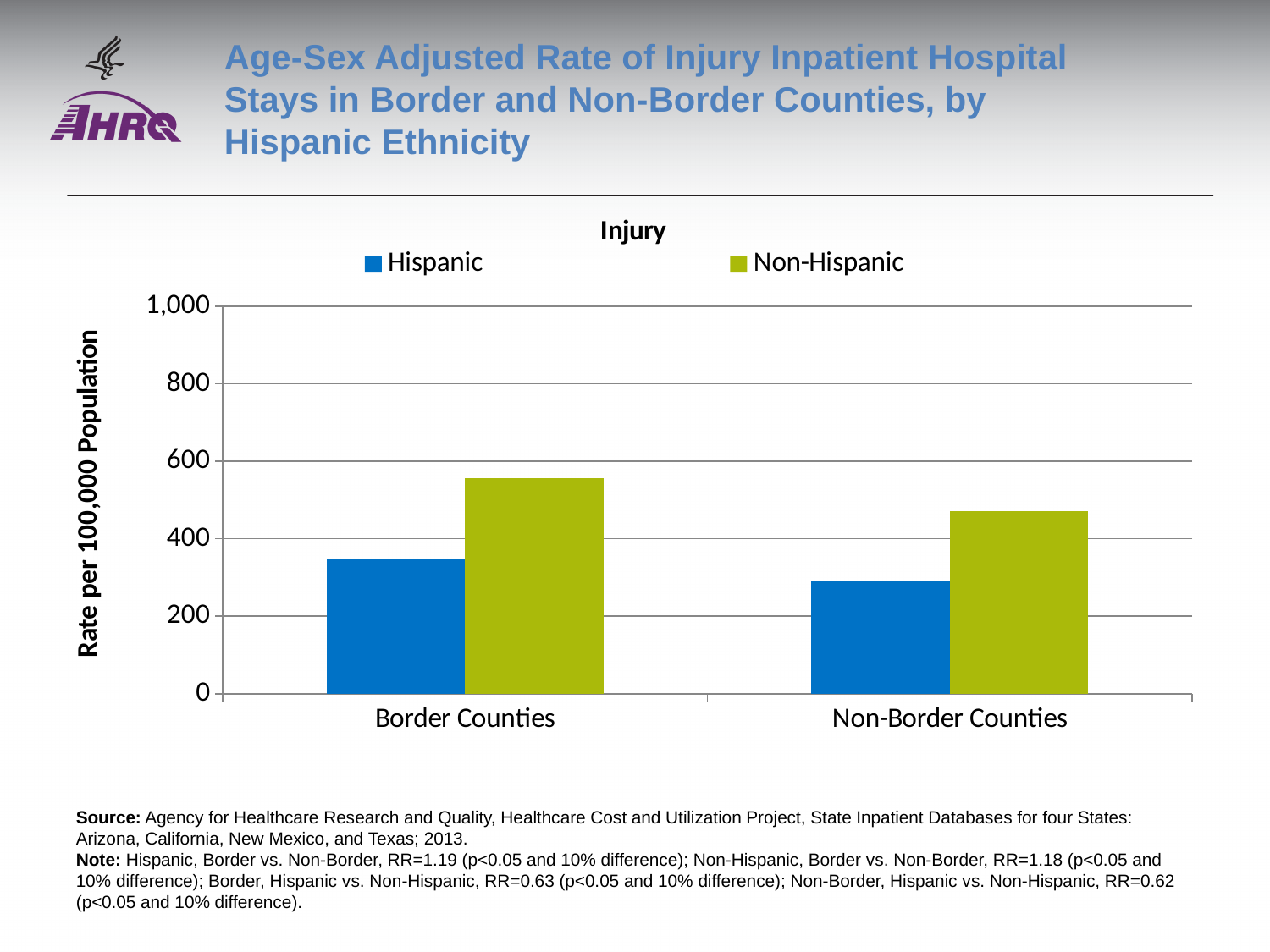
Which bar is the tallest in the chart? Non-Hispanic, Border Counties Is the Hispanic value for Border Counties greater or less than 400? less What is the label on the vertical axis of the chart? Rate per 100,000 Population What kind of chart is shown on the slide? Bar chart Is the Hispanic value for Non-Border Counties greater or less than 200? greater How many series does the legend list? 2 In Border Counties, which group has the higher rate, Hispanic or Non-Hispanic? Non-Hispanic How many county categories are shown on the x axis? 2 Which is larger, the Hispanic rate in Border Counties or the Hispanic rate in Non-Border Counties? Border Counties Is the Non-Hispanic value for Non-Border Counties greater or less than 600? less Which bar is the shortest in the chart? Hispanic, Non-Border Counties